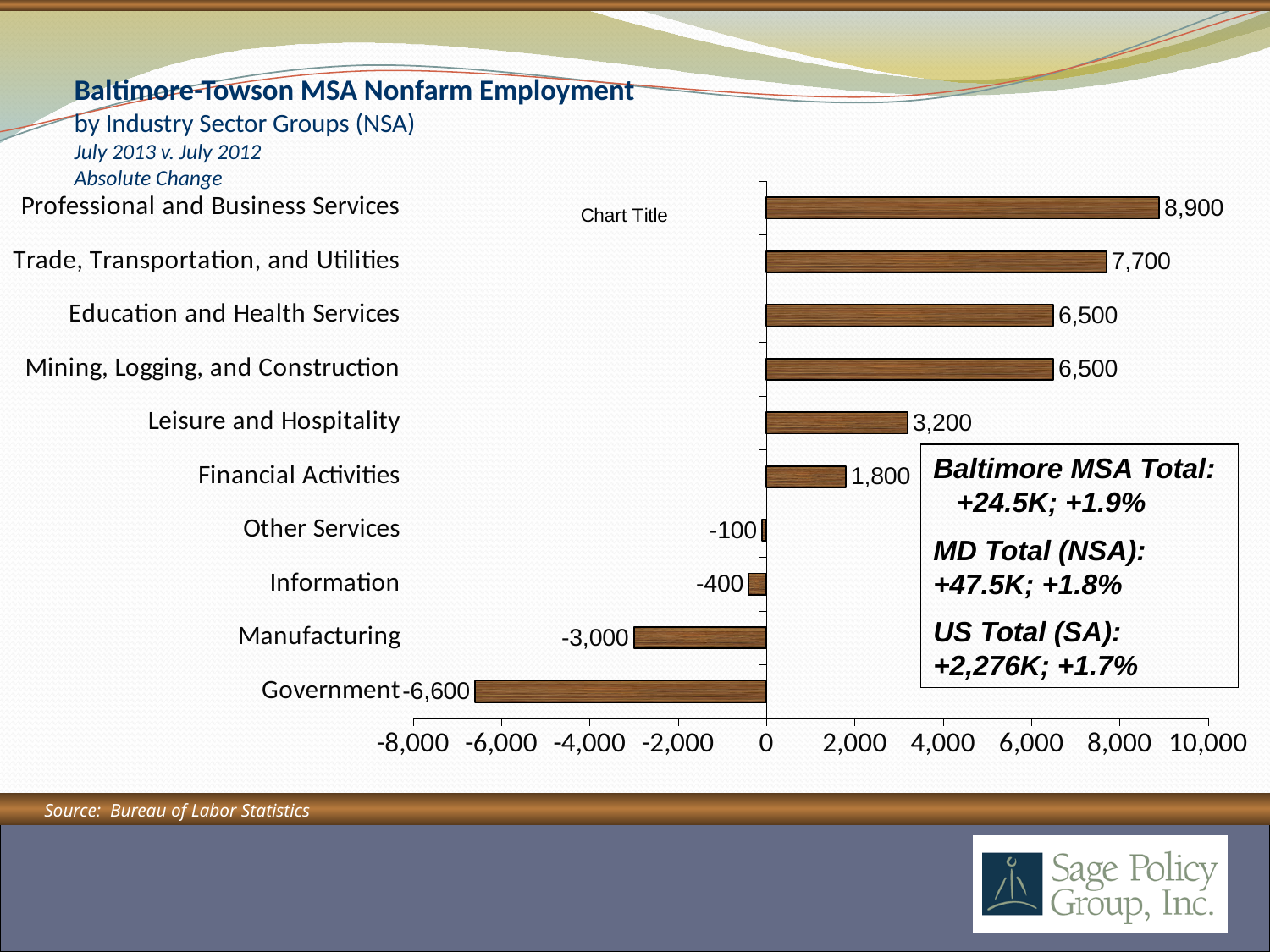
Which industry sector group has the lowest value? Government Which industry sector group has the highest value? Professional and Business Services What is the absolute change in employment for Professional and Business Services? 8,900 How many industry sector groups have a negative value? 4 What is the value shown for Financial Activities? 1,800 What is the difference between the values for Professional and Business Services and Trade, Transportation, and Utilities? 1,200 What is the value shown for Information? -400 What is the value shown for Government? -6,600 How many industry sector groups are shown in the chart? 10 What is the difference between the values for Manufacturing and Government? 3,600 What kind of chart is shown on the slide? Bar chart Which is larger, the value for Leisure and Hospitality or the value for Financial Activities? Leisure and Hospitality